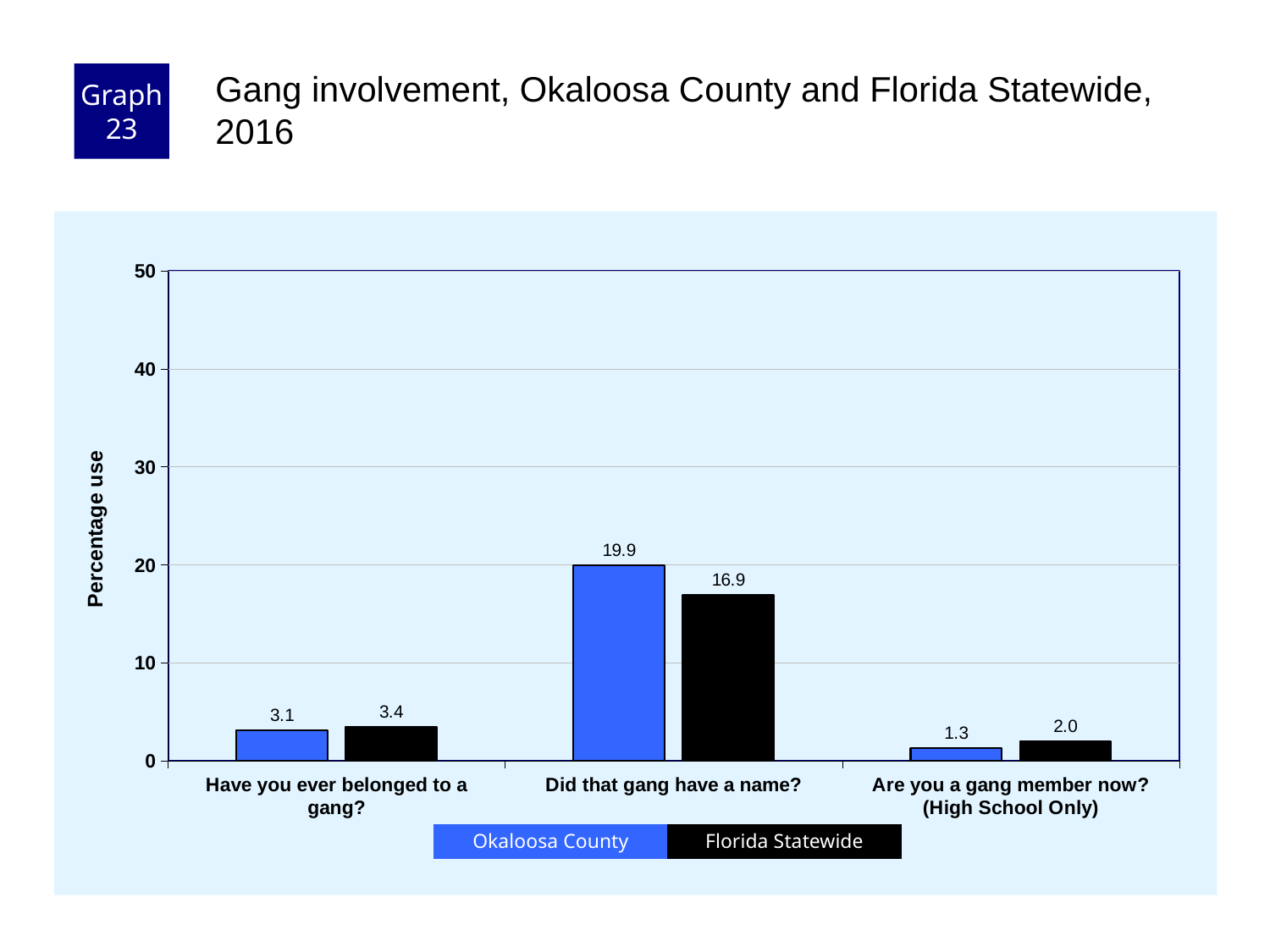
What is the Okaloosa County value for "Did that gang have a name?"? 19.9 What is the difference between the Okaloosa County and Florida Statewide values for "Did that gang have a name?"? 3.0 Which category has the lowest Florida Statewide value? Are you a gang member now? (High School Only) How many series does the legend list? 2 Is the Florida Statewide value for "Did that gang have a name?" greater or less than 20? less What is the label of the y axis? Percentage use For "Are you a gang member now? (High School Only)", which is larger: Okaloosa County or Florida Statewide? Florida Statewide Which category has the highest Okaloosa County value? Did that gang have a name? What is the Florida Statewide value for "Have you ever belonged to a gang?"? 3.4 How many categories are shown on the x axis? 3 What is the Okaloosa County value for "Are you a gang member now? (High School Only)"? 1.3 What kind of chart is shown on the slide? bar chart